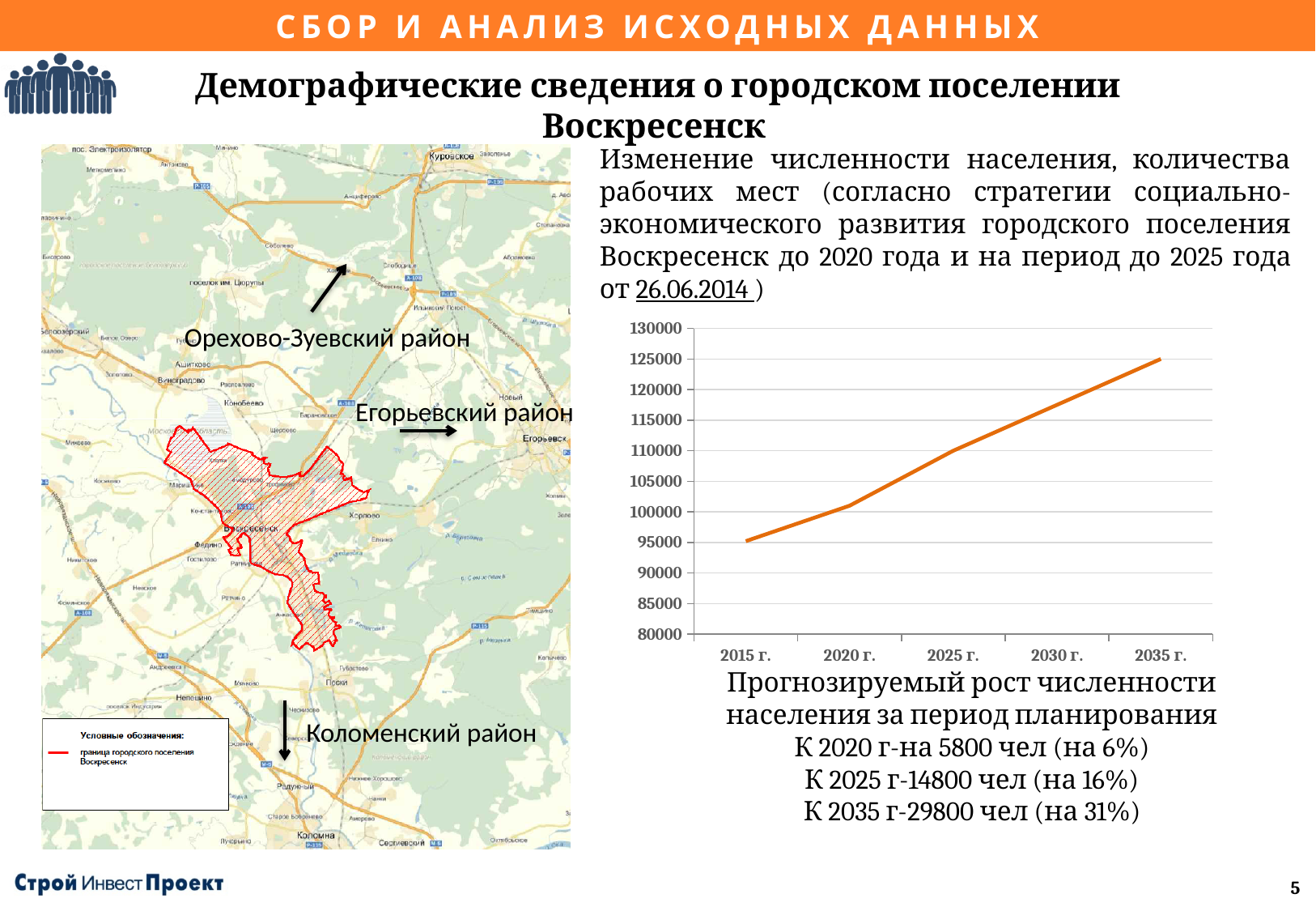
Is the value for 2030 г. greater or less than 115000? greater Is the value for 2025 г. greater or less than 105000? greater How many years are marked on the x axis of the chart? 5 Which year on the x axis has the lowest plotted value? 2015 г. Is the value for 2035 г. greater or less than 120000? greater Does the plotted population value rise or fall from 2015 г. to 2035 г.? rise Which year on the x axis has the highest plotted value? 2035 г. Which is larger, the value for 2035 г. or the value for 2015 г.? 2035 г. What colour is the line plotted on the chart? orange What kind of chart is shown on the slide? line chart